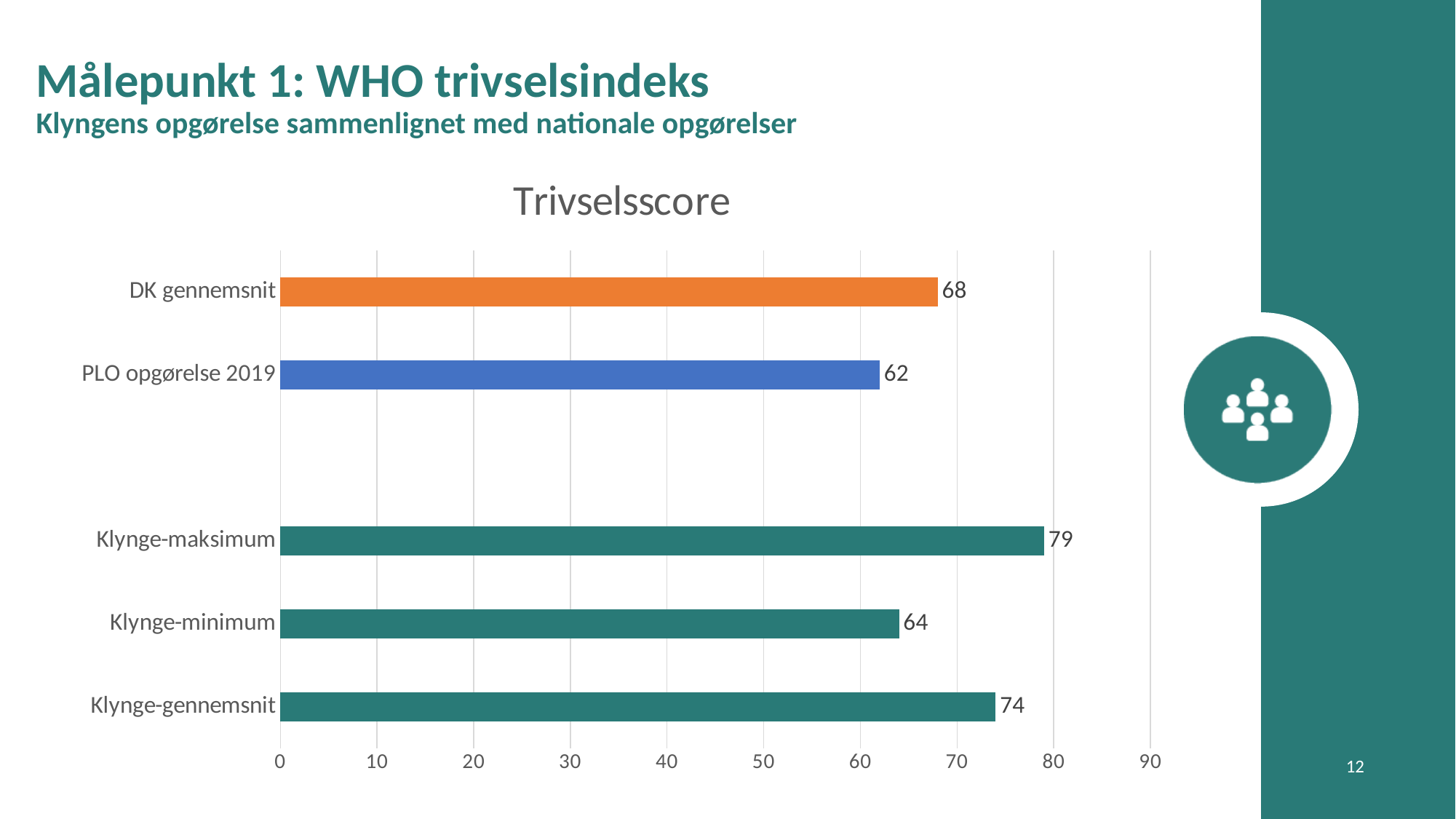
What is the title of the chart? Trivselsscore What kind of chart is shown? bar chart What is the value for Klynge-gennemsnit? 74 What is the value for Klynge-minimum? 64 Which is larger, DK gennemsnit or PLO opgørelse 2019? DK gennemsnit Which category has the lowest value? PLO opgørelse 2019 What is the difference between Klynge-maksimum and Klynge-minimum? 15 How many bars are shown in the chart? 5 What is the value for PLO opgørelse 2019? 62 What is the difference between Klynge-gennemsnit and DK gennemsnit? 6 Which category has the highest value? Klynge-maksimum What is the value for DK gennemsnit? 68